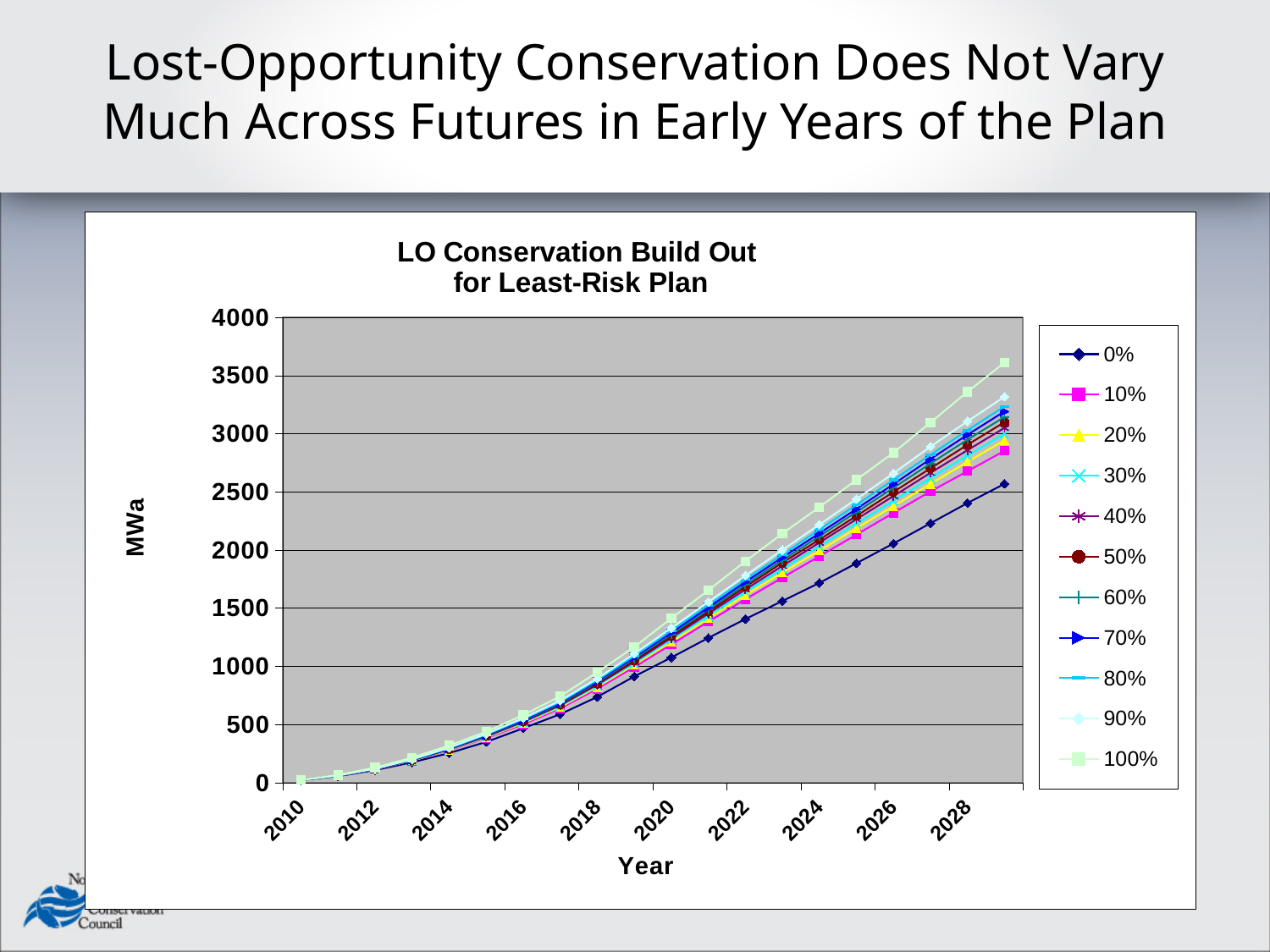
Which series has the lowest value in 2028? 0% Do the values of the series rise or fall as the year increases? rise What is the title of the chart? LO Conservation Build Out for Least-Risk Plan Is the value for the 100% series in 2028 greater or less than 3000? greater Is the value for the 100% series in 2020 greater or less than 1000? greater How many series does the legend list? 11 Is the value for the 0% series in 2028 greater or less than 2500? less What is the label on the vertical axis of the chart? MWa Which series has the highest value in 2028? 100% What kind of chart is shown on the slide? line chart In 2026, which is larger: the value for the 100% series or the value for the 0% series? 100%